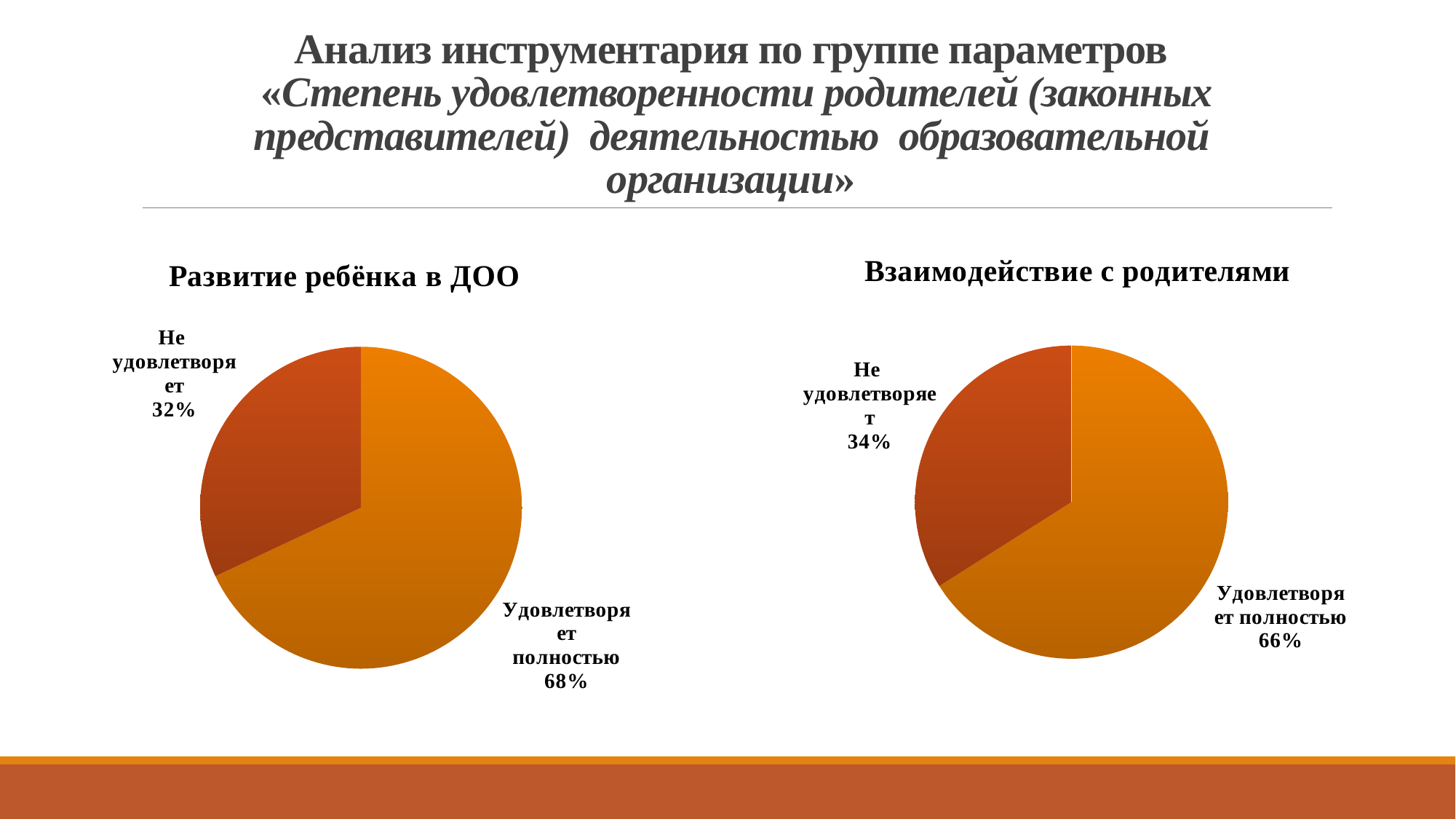
Which chart has the larger «Не удовлетворяет» share: «Развитие ребёнка в ДОО» or «Взаимодействие с родителями»? Взаимодействие с родителями What kind of chart is the chart titled «Взаимодействие с родителями»? Pie chart In the chart titled «Развитие ребёнка в ДОО», what share of the pie is «Не удовлетворяет»? 32% In the chart titled «Взаимодействие с родителями», what share of the pie is «Удовлетворяет полностью»? 66% In the chart titled «Развитие ребёнка в ДОО», what is the difference in percentage points between «Удовлетворяет полностью» and «Не удовлетворяет»? 36 In the chart titled «Взаимодействие с родителями», what share of the pie is «Не удовлетворяет»? 34% How many charts are shown on the slide? 2 In the chart titled «Развитие ребёнка в ДОО», which slice is the largest? Удовлетворяет полностью In the chart titled «Развитие ребёнка в ДОО», what share of the pie is «Удовлетворяет полностью»? 68% In the chart titled «Взаимодействие с родителями», what is the difference in percentage points between «Удовлетворяет полностью» and «Не удовлетворяет»? 32 In the chart titled «Взаимодействие с родителями», which slice is the smallest? Не удовлетворяет How many slices does the chart titled «Развитие ребёнка в ДОО» have? 2